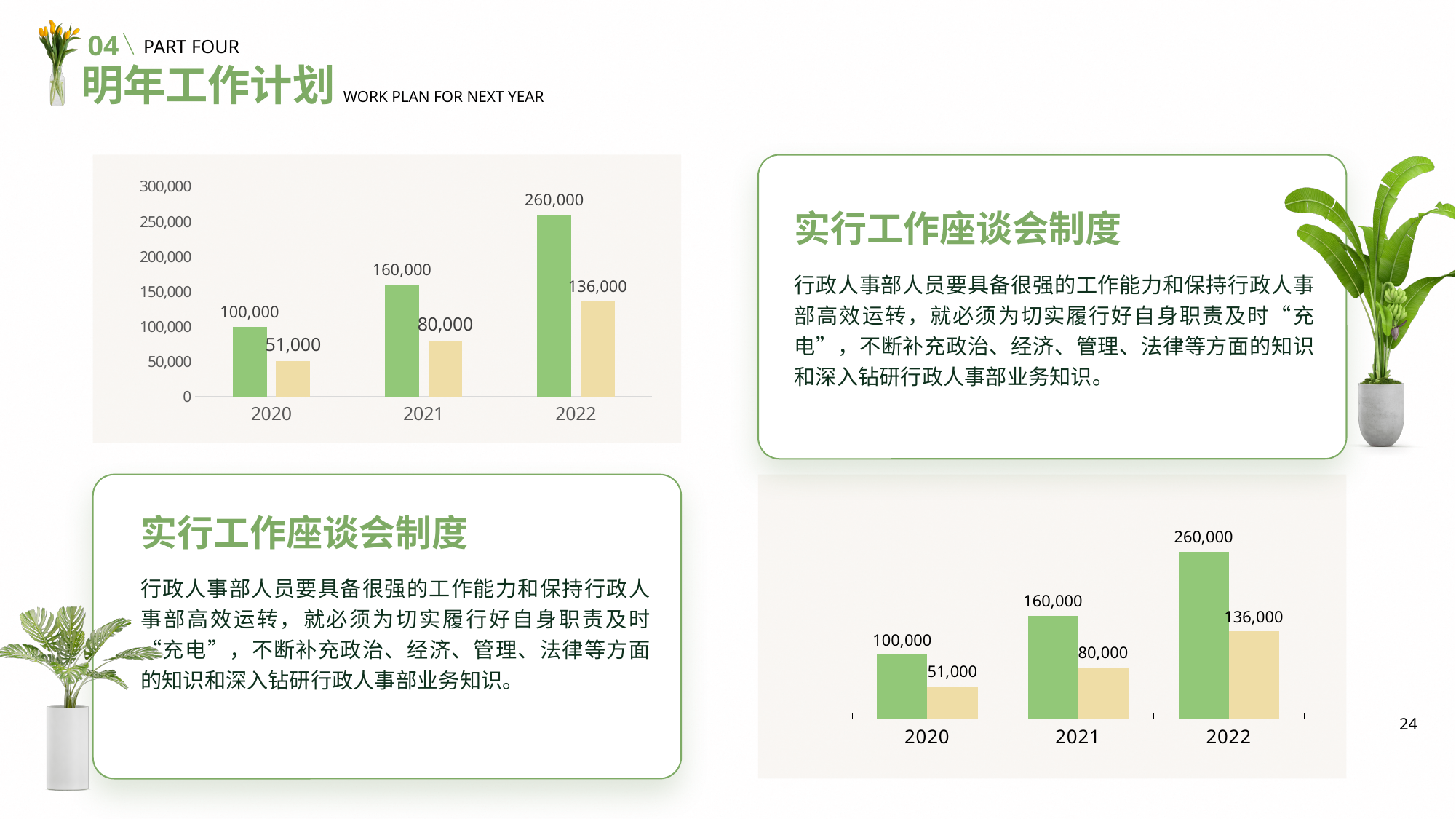
In the top-left chart, which year has the highest green bar? 2022 What type of chart is the top-left chart? bar chart In the bottom-right chart, which year has the lowest yellow bar? 2020 In the bottom-right chart, what is the difference between the green bar for 2021 and the green bar for 2020? 60,000 In the top-left chart, what is the difference between the green and yellow bars for 2022? 124,000 In the top-left chart, what is the value of the yellow bar for 2020? 51,000 In the bottom-right chart, what is the value of the yellow bar for 2022? 136,000 In the top-left chart, what is the value of the green bar for 2021? 160,000 In the top-left chart, which is larger: the yellow bar for 2022 or the green bar for 2020? the yellow bar for 2022 How many years are shown on the x axis of the bottom-right chart? 3 In the bottom-right chart, what is the value of the green bar for 2020? 100,000 In the top-left chart, is the green bar for 2022 greater or less than 250,000? greater